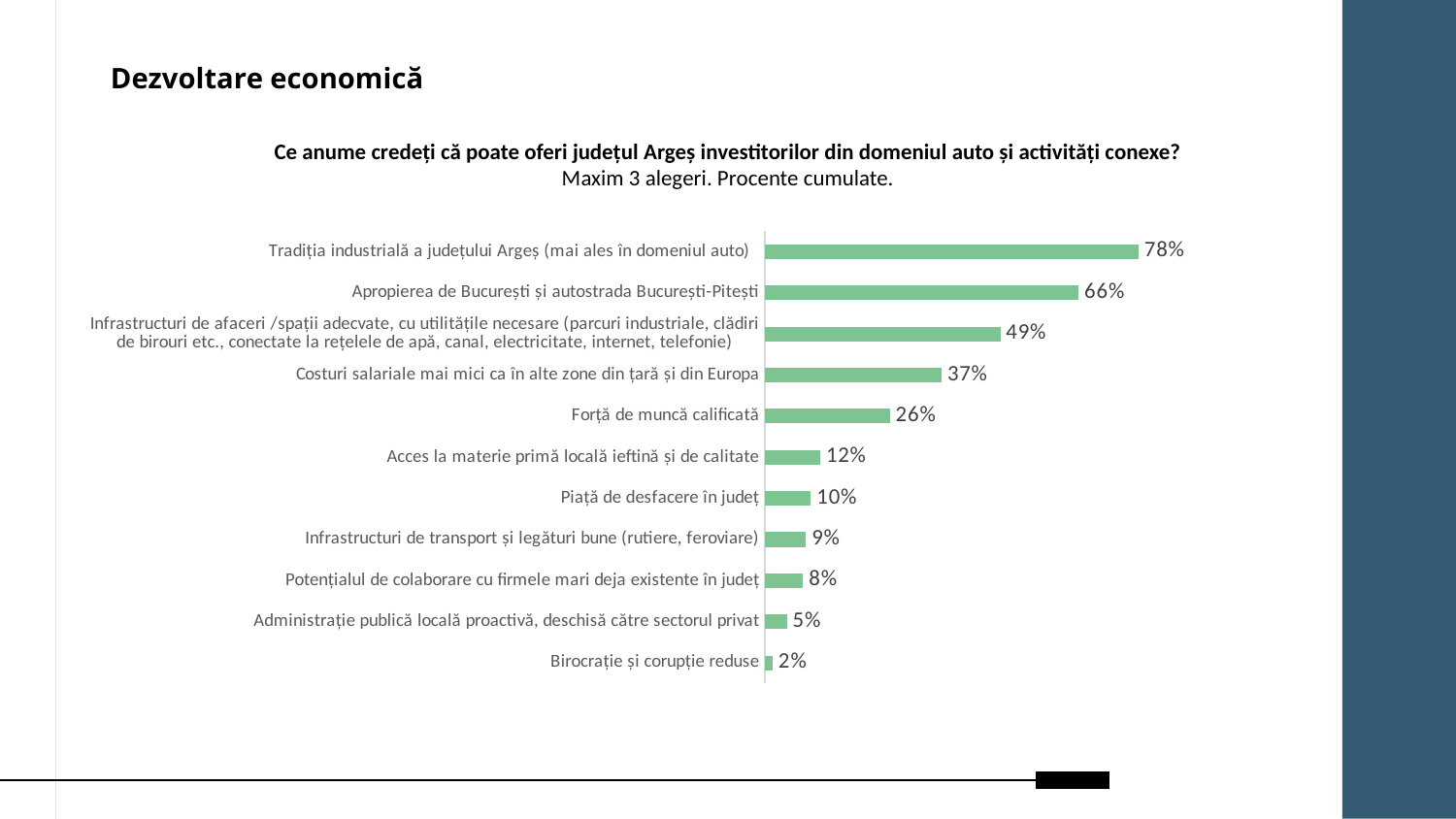
What type of chart is shown on the slide? Bar chart What percentage is shown for "Piață de desfacere în județ"? 10% What percentage is shown for "Forță de muncă calificată"? 26% What value is shown for "Administrație publică locală proactivă, deschisă către sectorul privat"? 5% What is the difference between the values for "Tradiția industrială a județului Argeș (mai ales în domeniul auto)" and "Apropierea de București și autostrada București-Pitești"? 12% What is the maximum number of choices respondents could make, according to the chart subtitle? 3 Which is larger: the value for "Acces la materie primă locală ieftină și de calitate" or for "Infrastructuri de transport și legături bune (rutiere, feroviare)"? Acces la materie primă locală ieftină și de calitate What is the difference between "Costuri salariale mai mici ca în alte zone din țară și din Europa" and "Forță de muncă calificată"? 11% Which category has the highest value? Tradiția industrială a județului Argeș (mai ales în domeniul auto) What value is shown for "Apropierea de București și autostrada București-Pitești"? 66% Which category has the lowest value? Birocrație și corupție reduse How many categories are shown in the chart? 11